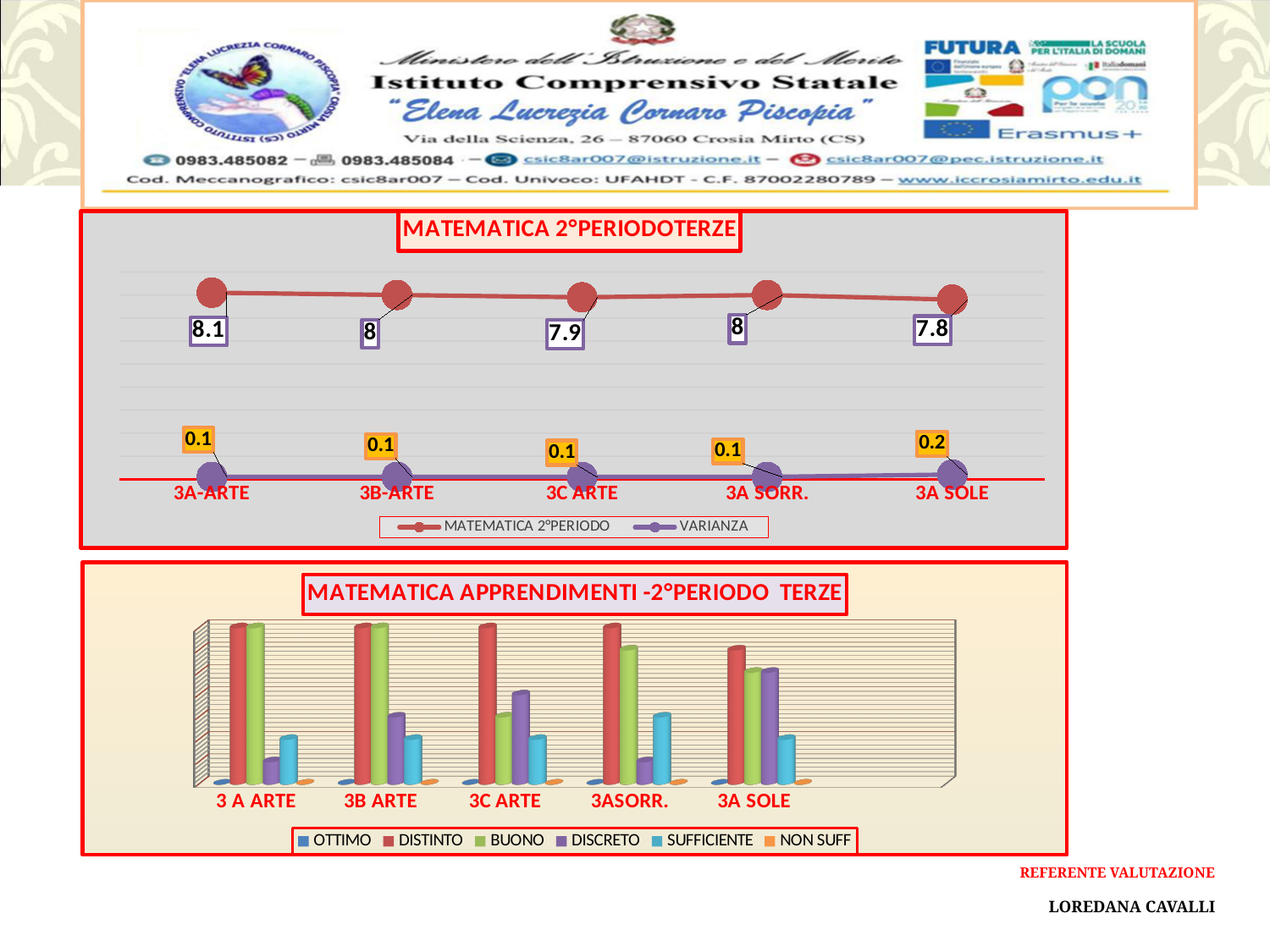
In the chart titled MATEMATICA 2°PERIODOTERZE, which class has the lowest MATEMATICA 2°PERIODO value? 3A SOLE What kind of chart is the one titled MATEMATICA APPRENDIMENTI -2°PERIODO TERZE? Bar chart In the chart titled MATEMATICA 2°PERIODOTERZE, what is the VARIANZA value for 3A SOLE? 0.2 In the chart titled MATEMATICA 2°PERIODOTERZE, which class has the highest MATEMATICA 2°PERIODO value? 3A-ARTE In the chart titled MATEMATICA 2°PERIODOTERZE, what is the MATEMATICA 2°PERIODO value for 3C ARTE? 7.9 In the chart titled MATEMATICA 2°PERIODOTERZE, how many classes are shown on the x axis? 5 In the chart titled MATEMATICA APPRENDIMENTI -2°PERIODO TERZE, how many series does the legend list? 6 In the chart titled MATEMATICA 2°PERIODOTERZE, how many series does the legend list? 2 In the chart titled MATEMATICA APPRENDIMENTI -2°PERIODO TERZE, which legend entry is shown in orange? NON SUFF In the chart titled MATEMATICA 2°PERIODOTERZE, what is the MATEMATICA 2°PERIODO value for 3A-ARTE? 8.1 In the chart titled MATEMATICA 2°PERIODOTERZE, what is the difference between the MATEMATICA 2°PERIODO values for 3A-ARTE and 3A SOLE? 0.3 In the chart titled MATEMATICA 2°PERIODOTERZE, which class has the highest VARIANZA value? 3A SOLE